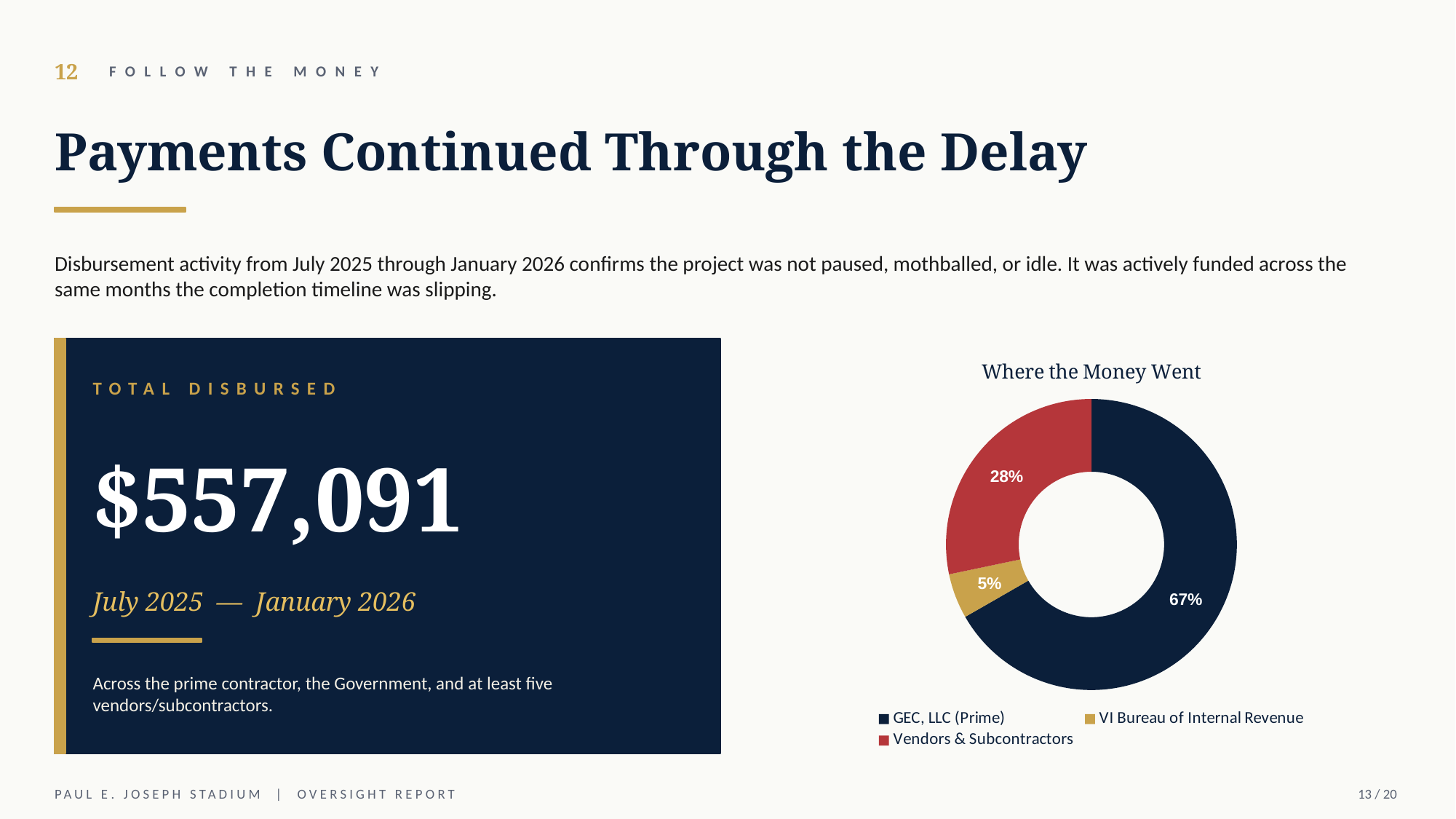
What is the title of the chart on the slide? Where the Money Went What share of the money went to the VI Bureau of Internal Revenue? 5% Which is larger: the share for Vendors & Subcontractors or the share for VI Bureau of Internal Revenue? Vendors & Subcontractors What kind of chart is shown on the slide? Pie chart (doughnut) How many categories does the pie chart show? 3 What share of the money went to Vendors & Subcontractors? 28% What colour represents Vendors & Subcontractors in the chart? Red What share of the money went to GEC, LLC (Prime)? 67% What is the difference in percentage points between the GEC, LLC (Prime) share and the Vendors & Subcontractors share? 39 percentage points Which category received the smallest share of the money? VI Bureau of Internal Revenue Which category received the largest share of the money? GEC, LLC (Prime) What is the combined share of Vendors & Subcontractors and VI Bureau of Internal Revenue? 33%